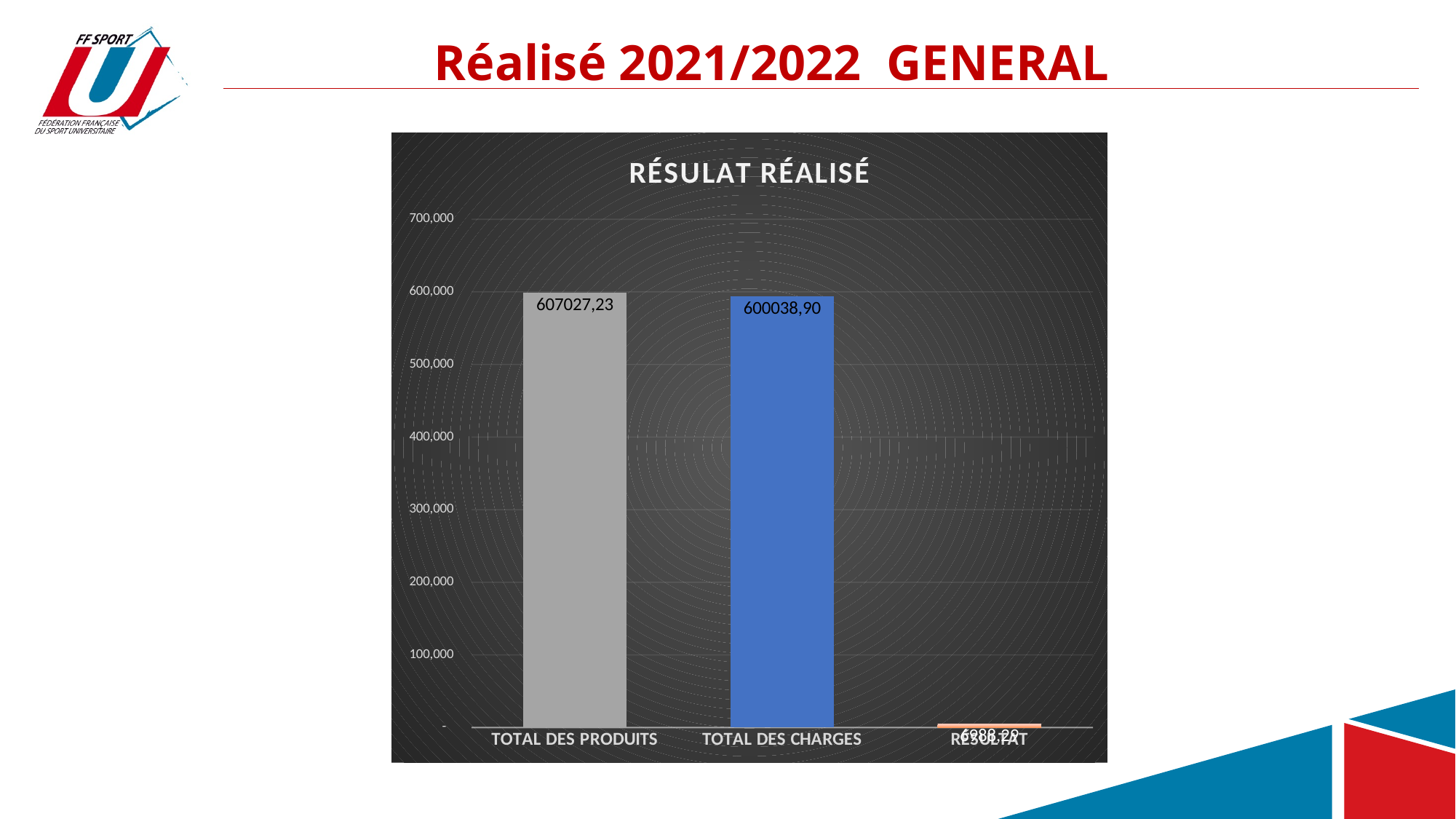
What is the difference between TOTAL DES PRODUITS and TOTAL DES CHARGES in the RÉSULAT RÉALISÉ chart? 6988,33 Which category has the lowest value in the RÉSULAT RÉALISÉ chart? RÉSULTAT Is the value for TOTAL DES CHARGES greater or less than 700,000? less Is the value for RESULTAT greater or less than 100,000? less Which is larger in the RÉSULAT RÉALISÉ chart, TOTAL DES PRODUITS or TOTAL DES CHARGES? TOTAL DES PRODUITS What is the value for TOTAL DES PRODUITS in the RÉSULAT RÉALISÉ chart? 607027,23 What is the value for TOTAL DES CHARGES in the RÉSULAT RÉALISÉ chart? 600038,90 Which category has the highest value in the RÉSULAT RÉALISÉ chart? TOTAL DES PRODUITS Is the value for TOTAL DES PRODUITS greater or less than 500,000? greater What is the title of the chart on the slide? RÉSULAT RÉALISÉ How many categories are shown in the RÉSULAT RÉALISÉ chart? 3 What kind of chart is shown on the slide? bar chart